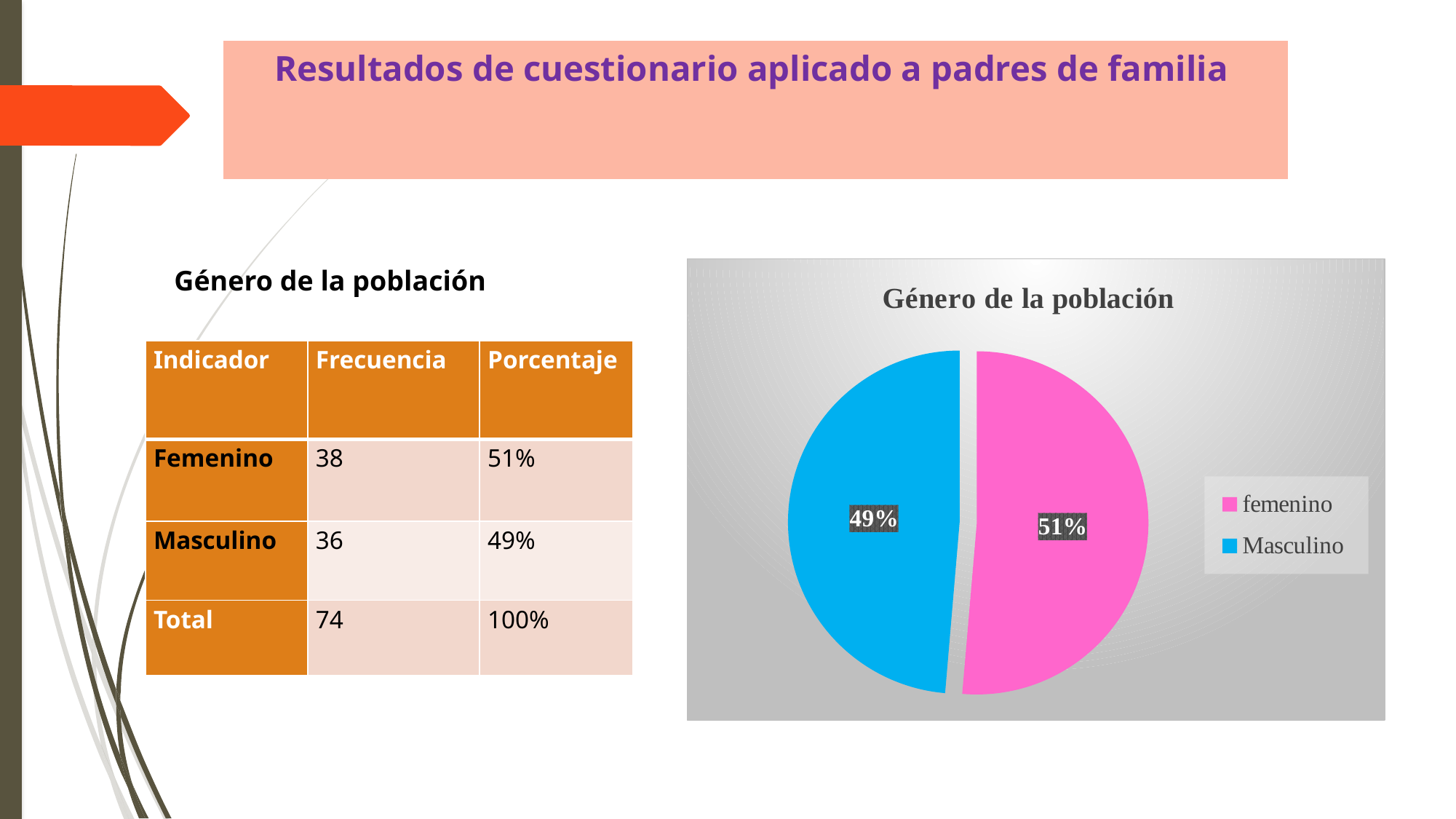
Is the value for Masculino greater or less than 50%? less What is the difference in percentage points between the femenino and Masculino slices? 2 Which slice of the pie is the smallest? Masculino How many entries does the legend list? 2 Which slice is larger, femenino or Masculino? femenino Which slice of the pie is the largest? femenino What share of the pie does the femenino slice represent? 51% What share of the pie does the Masculino slice represent? 49% What colour is the Masculino slice in the pie chart? blue What kind of chart is shown on the slide? pie chart How many slices does the pie chart have? 2 What is the title of the chart? Género de la población